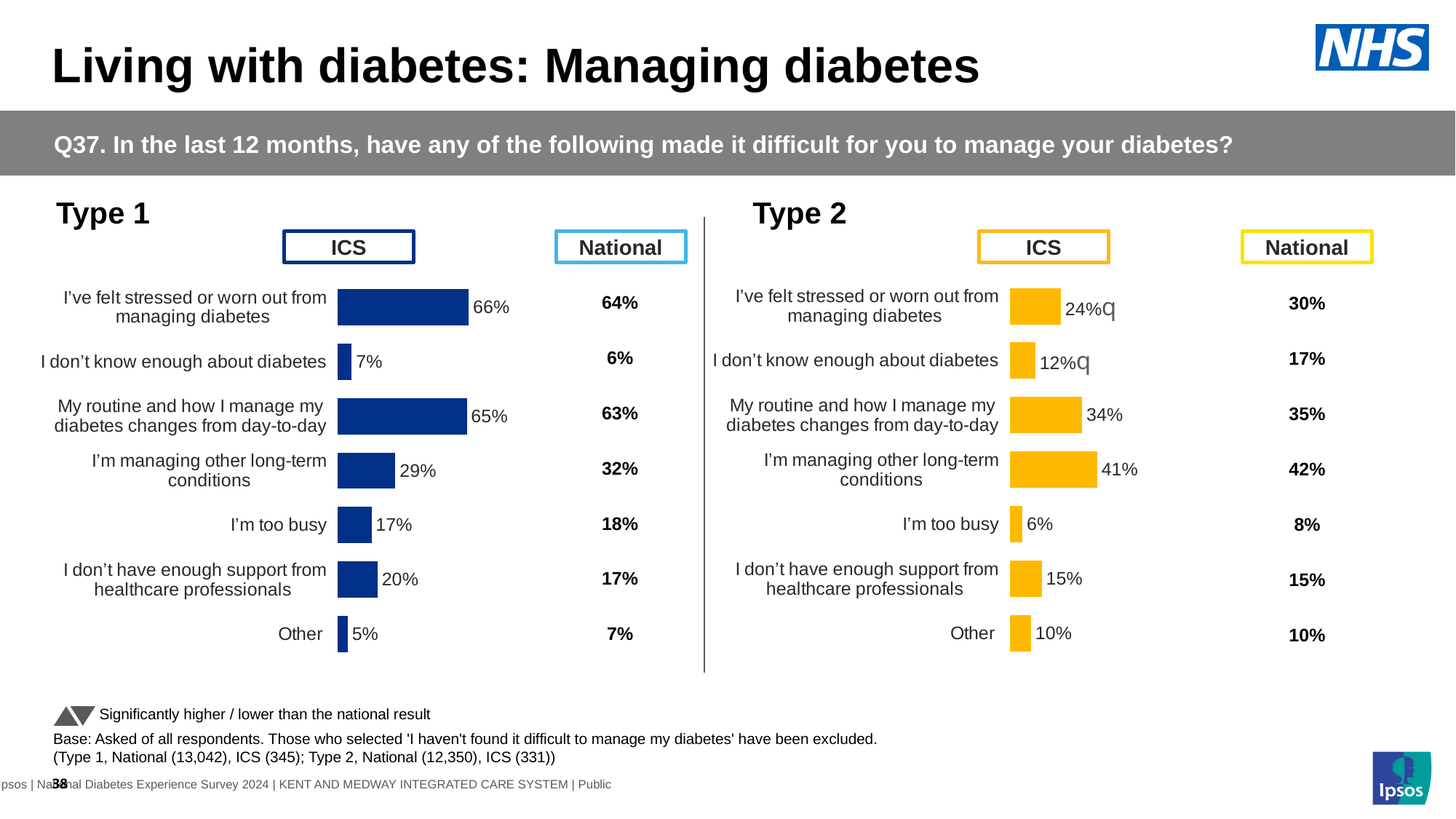
On the Type 1 chart, what is the National value for 'My routine and how I manage my diabetes changes from day-to-day'? 63% On the Type 2 chart, what is the difference between the National value and the ICS value for 'I don't know enough about diabetes'? 5% On the Type 2 chart, which category has the lowest ICS value? I'm too busy How many categories are shown on the Type 1 chart? 7 On the Type 1 chart, which category has the lowest ICS value? Other What kind of chart is used for the Type 2 ICS results? Bar chart On the Type 1 chart, what is the difference between the ICS value for 'I'm managing other long-term conditions' and the ICS value for 'I'm too busy'? 12% On the Type 2 chart, which category has the highest ICS value? I'm managing other long-term conditions On the Type 1 chart, what is the ICS value for 'I've felt stressed or worn out from managing diabetes'? 66% On the Type 1 chart, which is larger: the ICS value for 'I'm too busy' or the ICS value for 'I don't have enough support from healthcare professionals'? I don't have enough support from healthcare professionals On the Type 2 chart, what is the ICS value for 'I'm managing other long-term conditions'? 41% On the Type 2 chart, which is larger: the ICS value or the National value for 'I've felt stressed or worn out from managing diabetes'? National